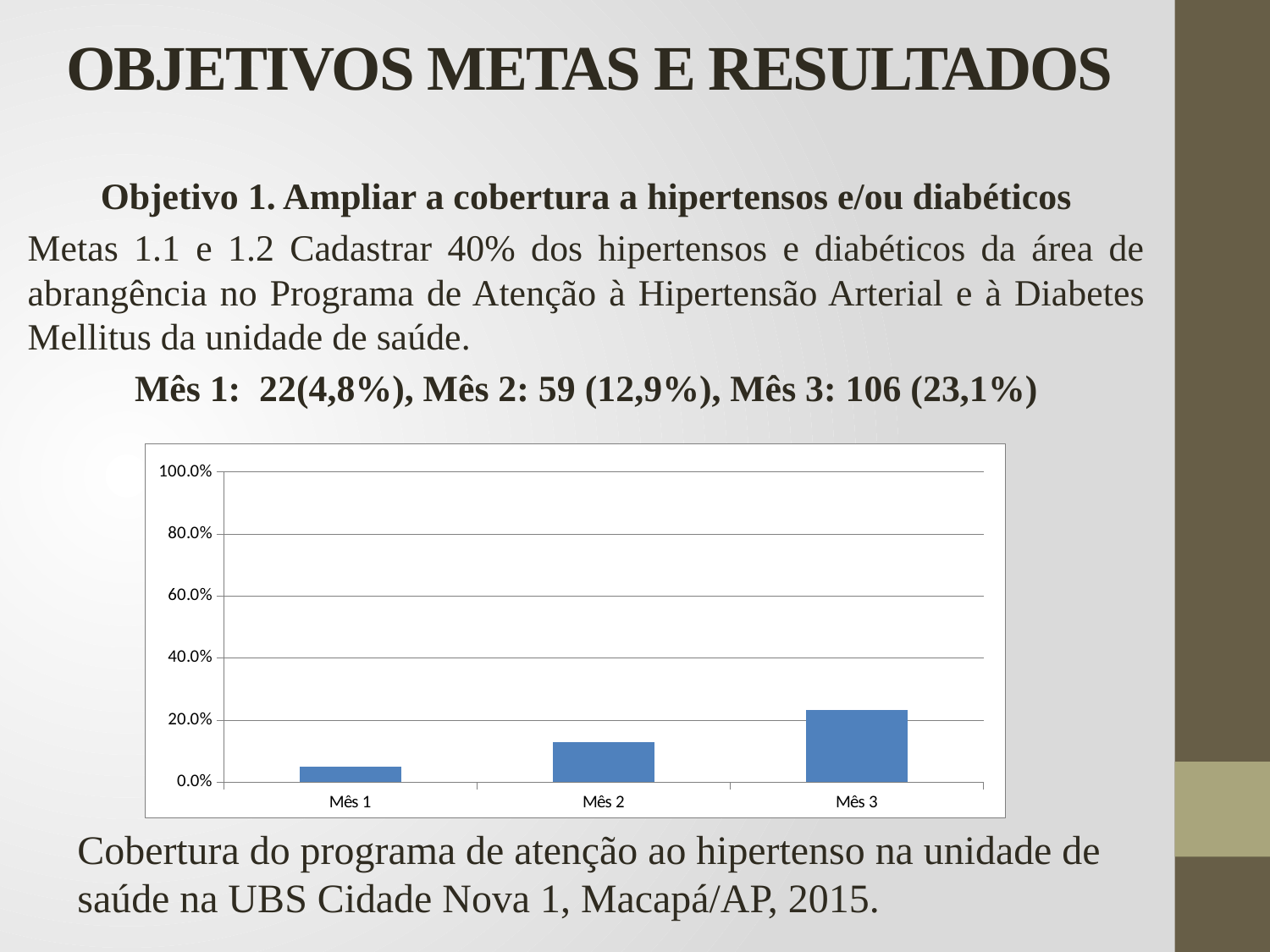
Which month has the highest bar in the chart? Mês 3 Which is larger, the bar for Mês 2 or the bar for Mês 1? Mês 2 How many categories are shown on the x axis of the chart? 3 Is the value for Mês 3 greater or less than 20.0%? greater According to the text above the chart, what coverage percentage was reached in Mês 3? 23,1% What is the highest value shown on the chart's vertical axis? 100.0% What kind of chart is shown on the slide? bar chart Is the value for Mês 3 greater or less than 40.0%? less Which month has the lowest bar in the chart? Mês 1 Do the values rise or fall from Mês 1 to Mês 3? rise Is the value for Mês 1 greater or less than 20.0%? less